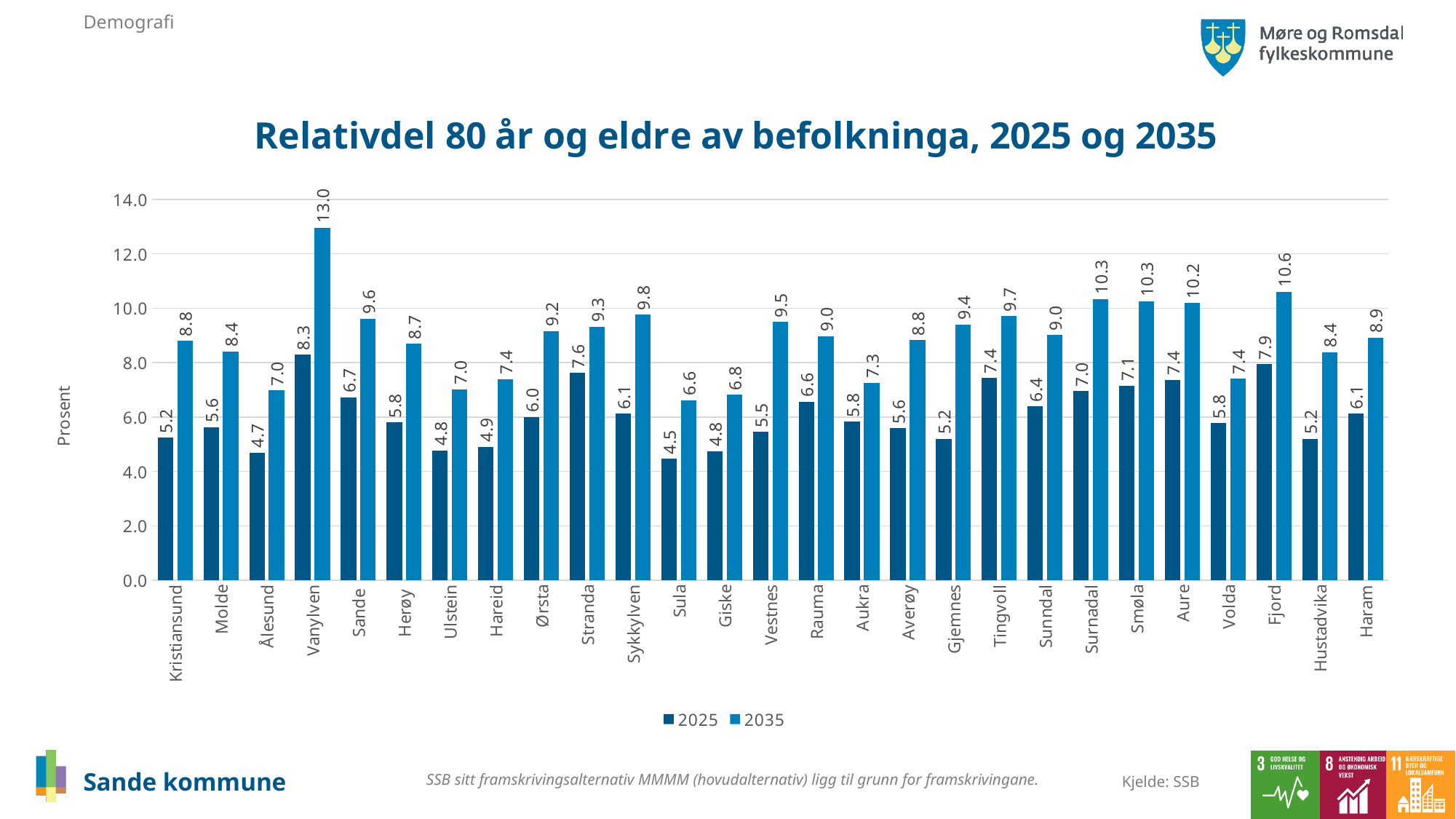
What kind of chart is shown on the slide? Bar chart How many municipalities are shown on the x axis? 27 Is the 2035 value for Surnadal greater or less than 10.0? greater Which municipality has the lowest value in the 2025 series? Sula What is the value for Sande in the 2025 series? 6.7 What is the difference between the 2035 and 2025 values for Vestnes? 4.0 Which municipality has the highest value in the 2035 series? Vanylven Which is larger: the 2025 value for Stranda or the 2025 value for Tingvoll? Stranda How many series does the legend list? 2 What is the value for Fjord in the 2035 series? 10.6 What is the value for Vanylven in the 2035 series? 13.0 What is the label on the vertical axis? Prosent